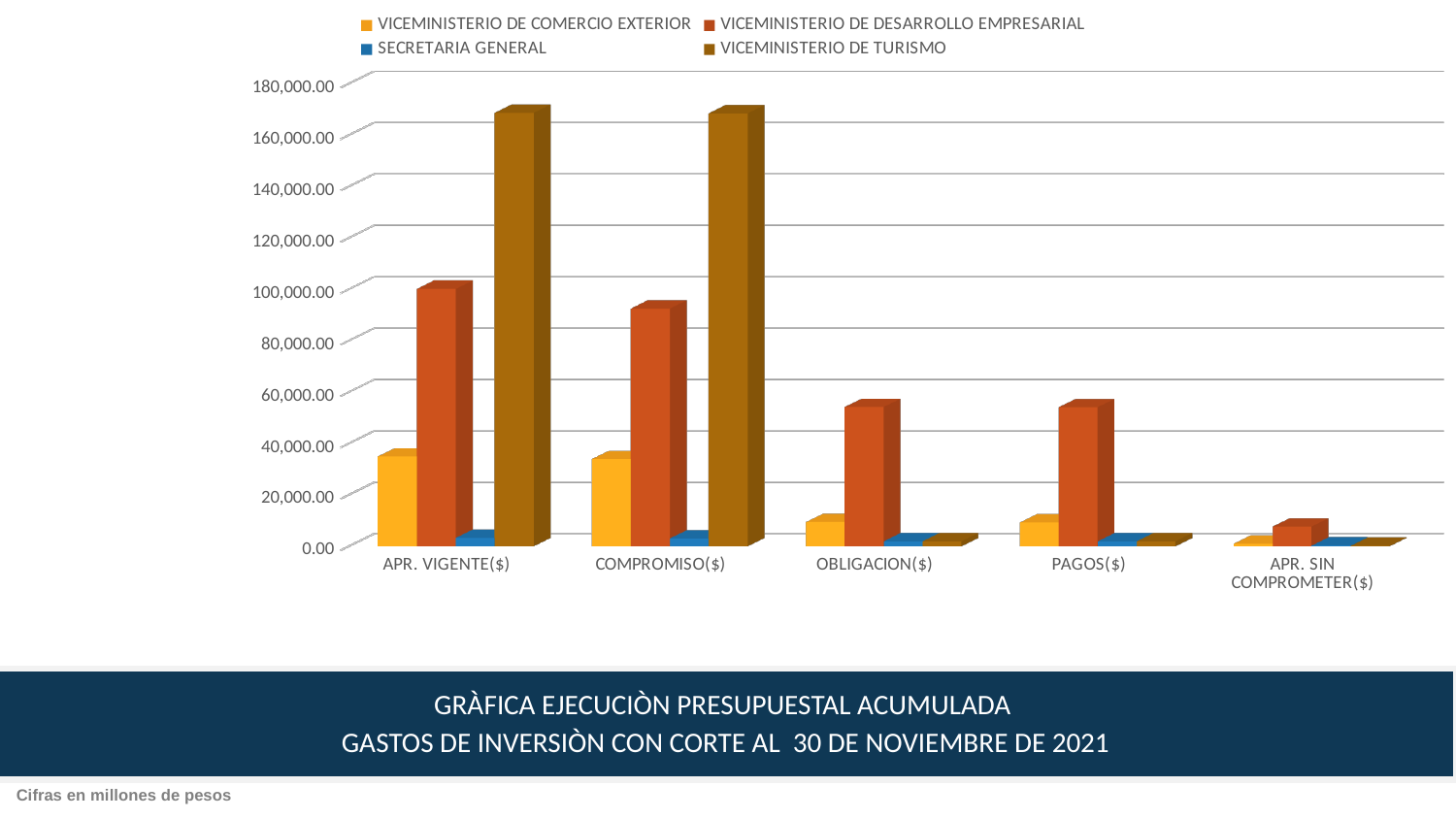
How many series does the chart's legend list? 4 Is the value for VICEMINISTERIO DE COMERCIO EXTERIOR in APR. VIGENTE($) greater or less than 40,000.00? less Is the value for VICEMINISTERIO DE DESARROLLO EMPRESARIAL in OBLIGACION($) greater or less than 40,000.00? greater How many categories are shown on the x axis of the chart? 5 In the APR. VIGENTE($) category, which series has the highest bar? VICEMINISTERIO DE TURISMO Is the value for VICEMINISTERIO DE TURISMO in APR. VIGENTE($) greater or less than 160,000.00? greater What kind of chart is shown on the slide? Bar chart In the APR. VIGENTE($) category, which series has the lowest bar? SECRETARIA GENERAL In the OBLIGACION($) category, which series has the highest bar? VICEMINISTERIO DE DESARROLLO EMPRESARIAL In the PAGOS($) category, which is larger: VICEMINISTERIO DE DESARROLLO EMPRESARIAL or VICEMINISTERIO DE COMERCIO EXTERIOR? VICEMINISTERIO DE DESARROLLO EMPRESARIAL What colour represents VICEMINISTERIO DE TURISMO in the chart's legend? Brown Does the VICEMINISTERIO DE COMERCIO EXTERIOR series generally rise or fall from APR. VIGENTE($) to APR. SIN COMPROMETER($)? fall